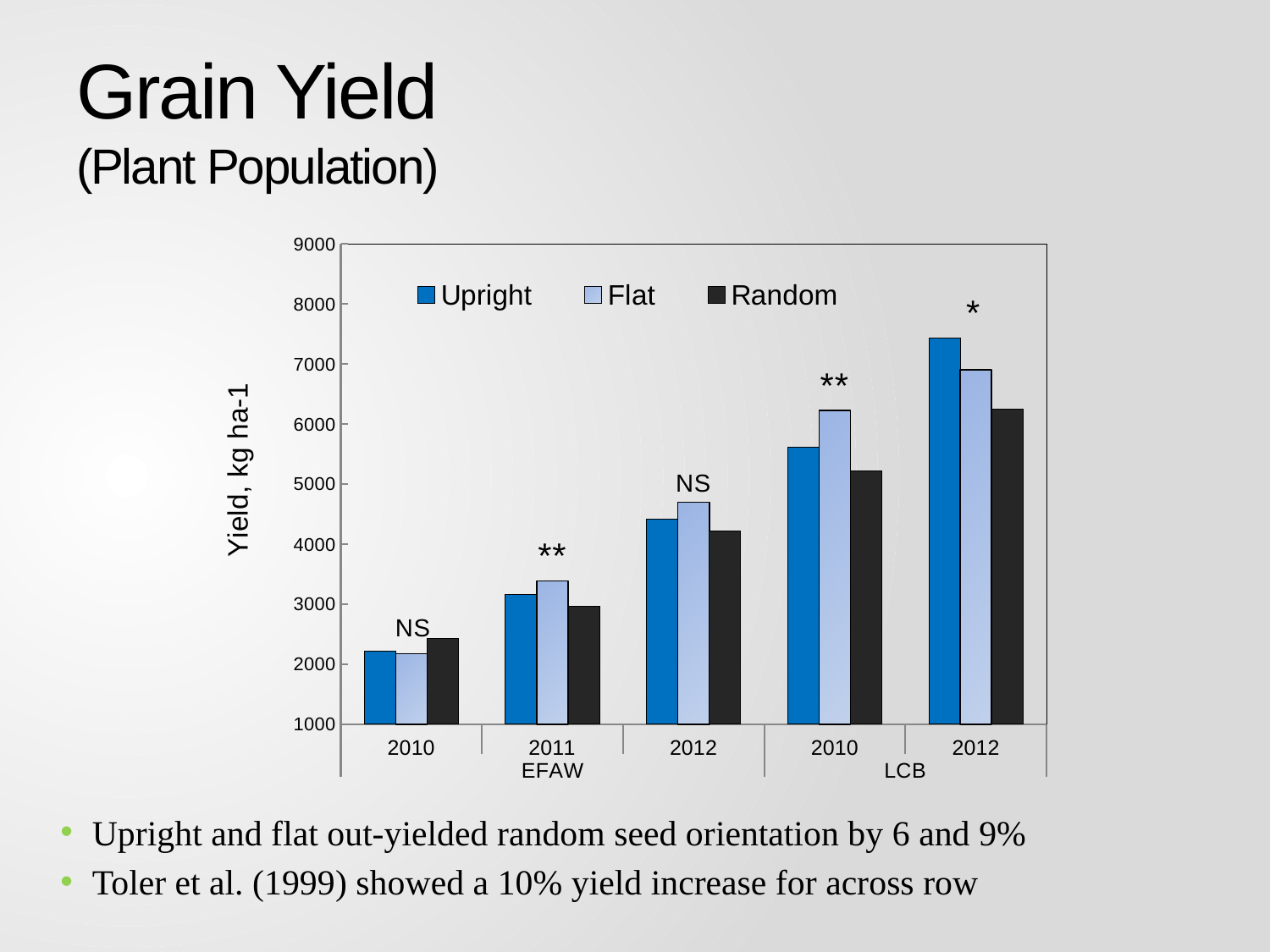
How many series does the legend list? 3 How many year groups are plotted along the x axis? 5 What kind of chart is shown on the slide? bar chart Is the Flat value for EFAW 2012 greater or less than 5000? less Is the Upright value for LCB 2010 greater or less than 6000? less Which series has the tallest bar in the whole chart, and in which group? Upright, LCB 2012 Do the yields at EFAW rise or fall from 2010 to 2012? rise Which year group has the lowest yields overall? EFAW 2010 Is the Upright value for LCB 2012 greater or less than 7000? greater At LCB 2010, which is larger, the Flat bar or the Random bar? Flat What is the label on the y axis? Yield, kg ha-1